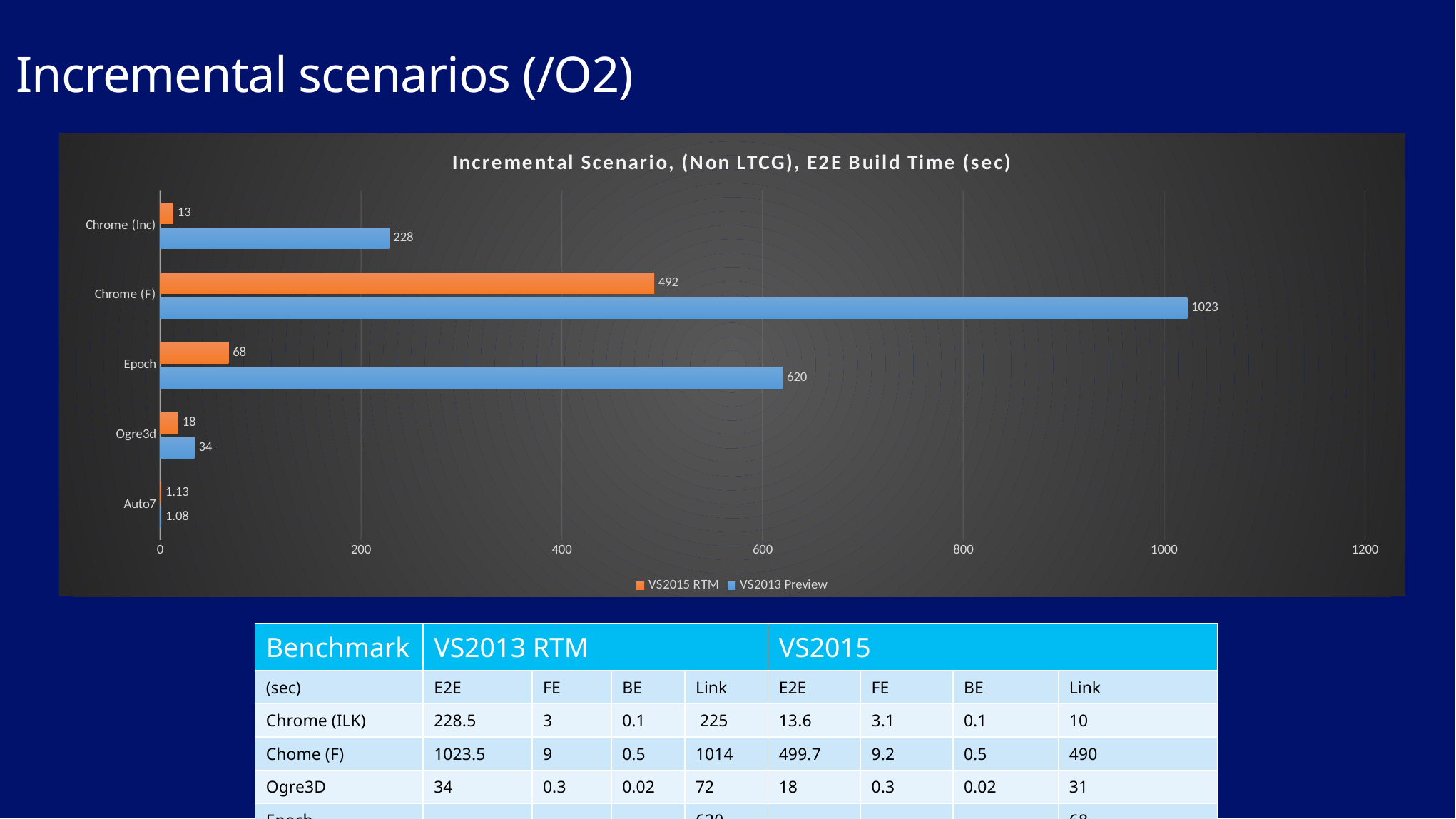
What is the VS2013 Preview value for Chrome (F)? 1023 How many series does the legend list? 2 What is the VS2015 RTM value for Auto7? 1.13 What is the VS2013 Preview value for Chrome (Inc)? 228 What is the difference between the VS2013 Preview and VS2015 RTM values for Epoch? 552 Which category has the highest VS2013 Preview value? Chrome (F) What is the VS2015 RTM value for Epoch? 68 Which is larger for Ogre3d: the VS2015 RTM value or the VS2013 Preview value? VS2013 Preview Which category has the lowest VS2015 RTM value? Auto7 What is the difference between the VS2013 Preview and VS2015 RTM values for Chrome (F)? 531 What type of chart is shown? Bar chart How many categories are shown on the chart? 5